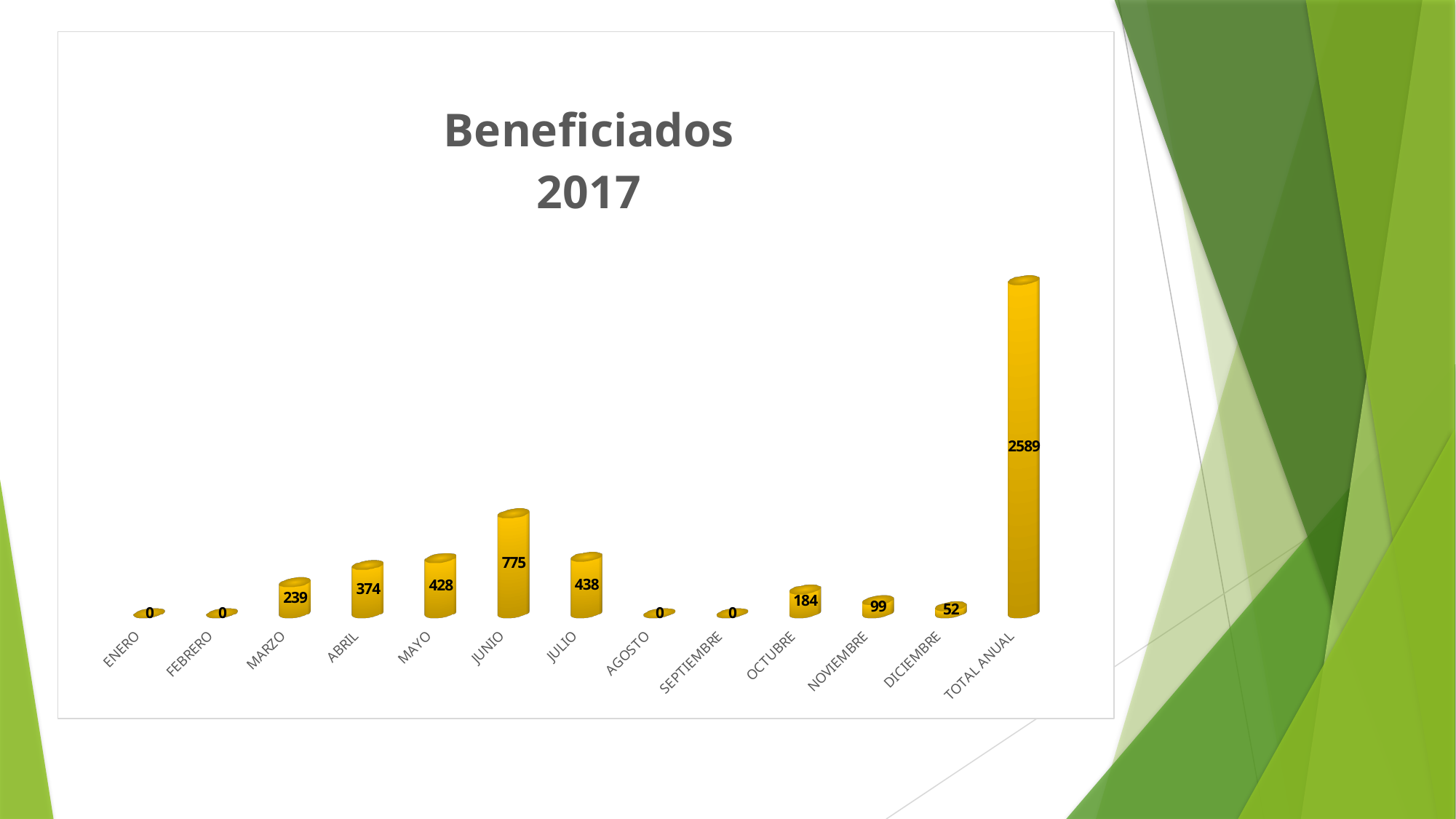
What is the value for MARZO? 239 What is the value for NOVIEMBRE? 99 What is the difference between the values for JUNIO and JULIO? 337 How many months have a value of 0? 4 What kind of chart is this? bar chart Which is larger, the value for OCTUBRE or the value for DICIEMBRE? OCTUBRE What is the title of the chart? Beneficiados 2017 How many categories are shown on the x axis? 13 What is the value for TOTAL ANUAL? 2589 What is the difference between the values for MAYO and ABRIL? 54 Which month has the highest value? JUNIO What is the value for JUNIO? 775